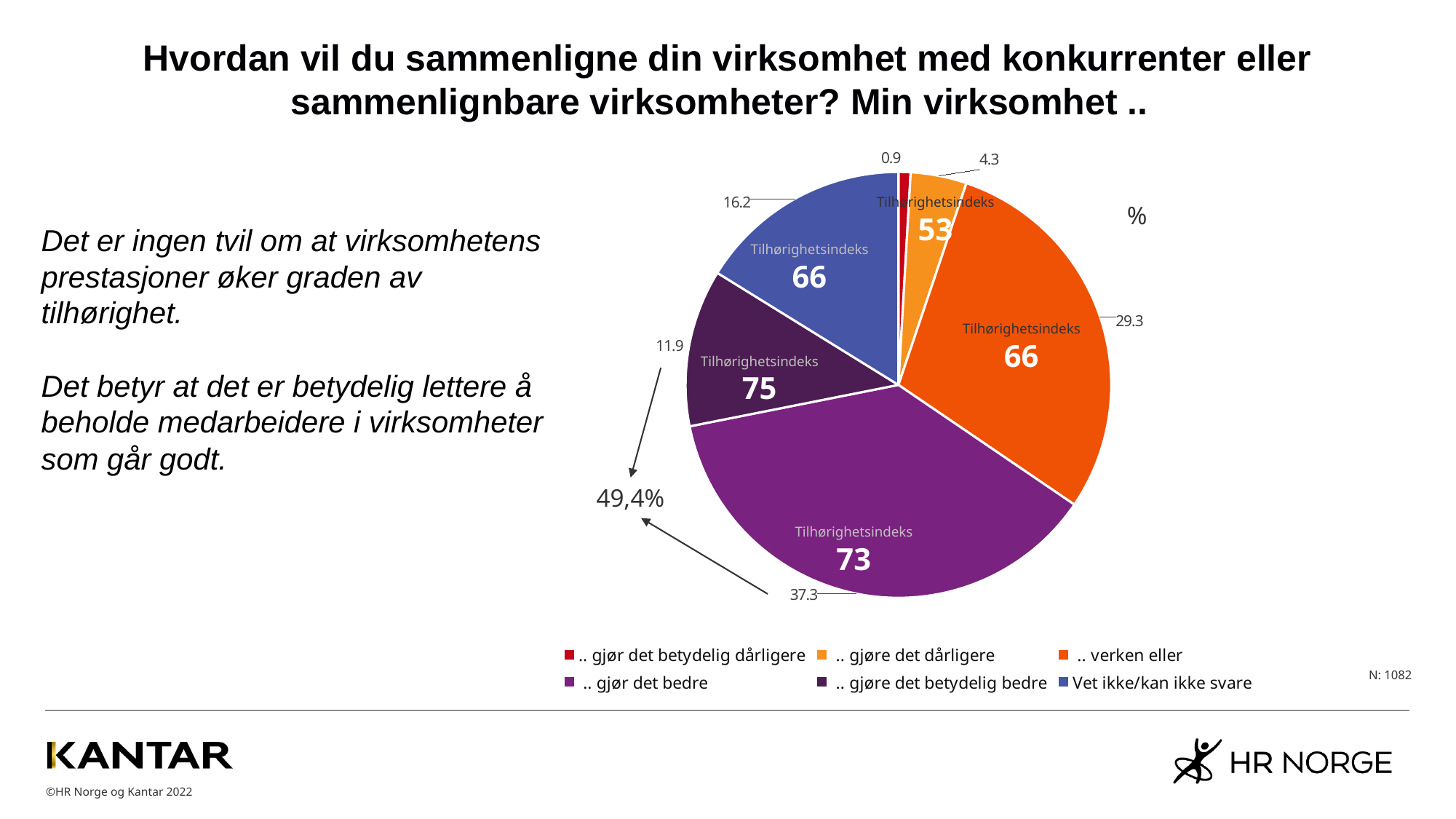
What is the value for '.. gjør det betydelig dårligere'? 0.9 What is the value for '.. gjøre det betydelig bedre'? 11.9 What is the value for 'Vet ikke/kan ikke svare'? 16.2 What is the difference between the values for '.. gjør det bedre' and '.. verken eller'? 8 Which category has the largest slice of the pie? .. gjør det bedre What is the value for '.. gjør det bedre'? 37.3 How many entries does the legend list? 6 What kind of chart is shown on the slide? pie chart What Tilhørighetsindeks is shown on the '.. gjøre det betydelig bedre' slice? 75 How many slices does the pie chart have? 6 Which category has the smallest slice of the pie? .. gjør det betydelig dårligere What is the value for '.. verken eller'? 29.3